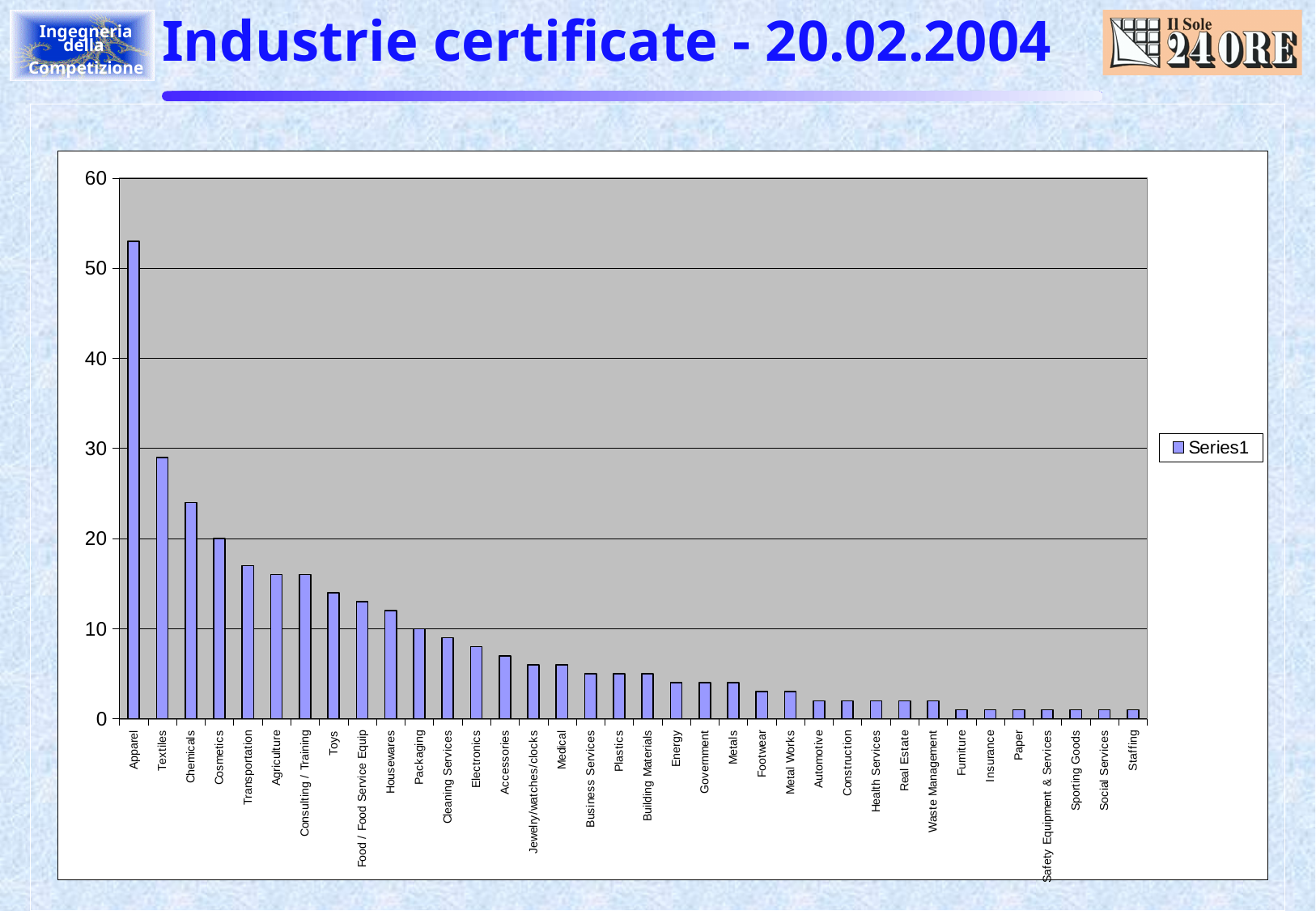
Is the value for Electronics greater or less than 10? less Is the value for Chemicals greater or less than 20? greater Do the values rise or fall moving from left to right along the x axis? fall Is the value for Textiles greater or less than 30? less What kind of chart is shown on the slide? bar chart How many series does the legend list? 1 How many categories are plotted on the x axis? 36 What is the name of the series shown in the legend? Series1 Which is larger, the value for Textiles or the value for Chemicals? Textiles Which category has the highest value? Apparel What is the title of the slide containing the chart? Industrie certificate - 20.02.2004